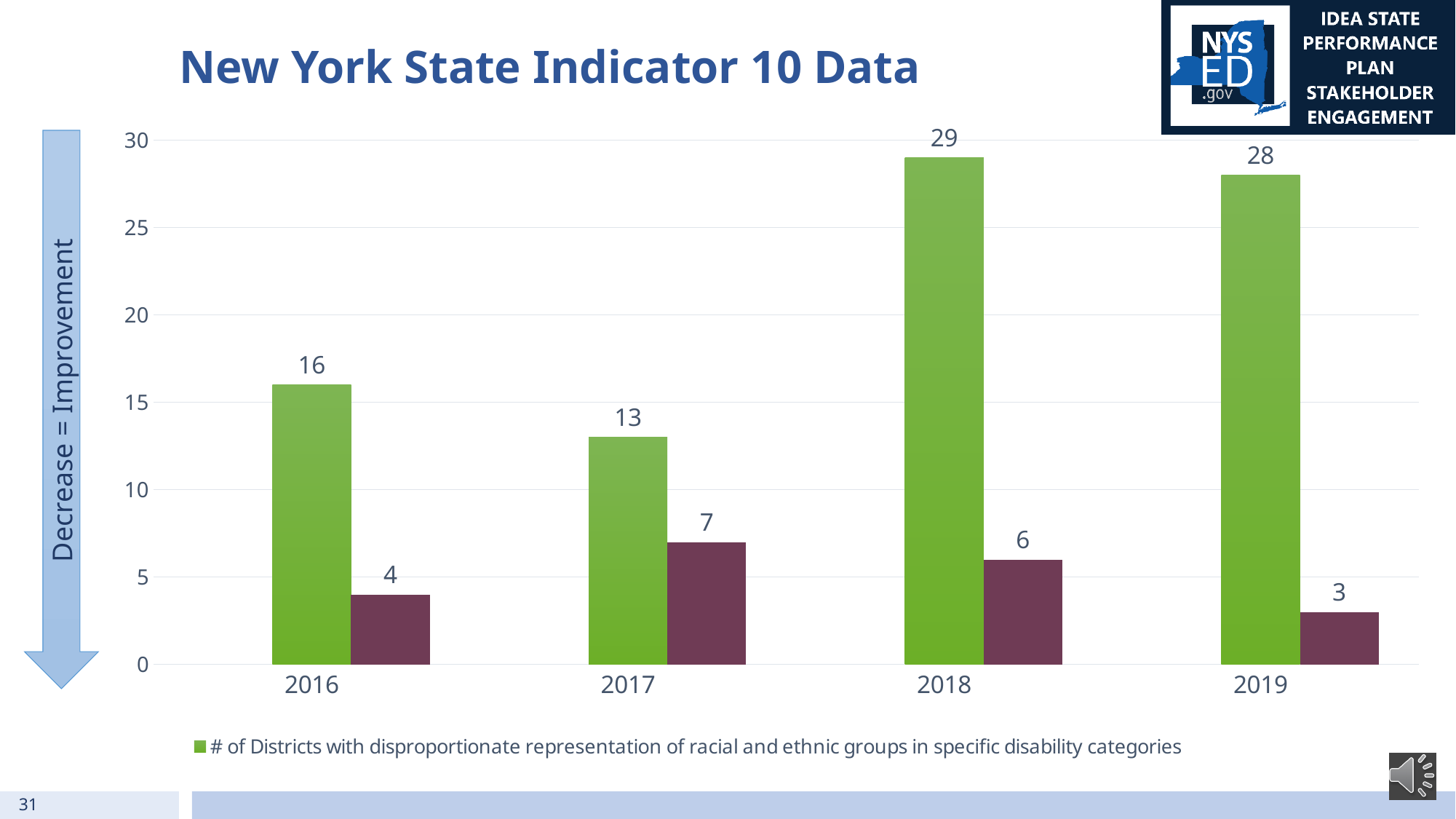
Is the green bar for 2019 greater or less than 25? greater What is the value of the green bar for 2018? 29 What is the title of the slide containing the chart? New York State Indicator 10 Data What is the value of the purple bar for 2017? 7 In which year is the green bar highest? 2018 How many series does the legend list? 1 In which year is the purple bar lowest? 2019 What kind of chart is shown on the slide? bar chart Which is larger, the purple bar for 2016 or the purple bar for 2017? 2017 What is the difference between the green bar values for 2018 and 2017? 16 How many years are shown on the x axis? 4 What is the value of the green bar for 2016? 16